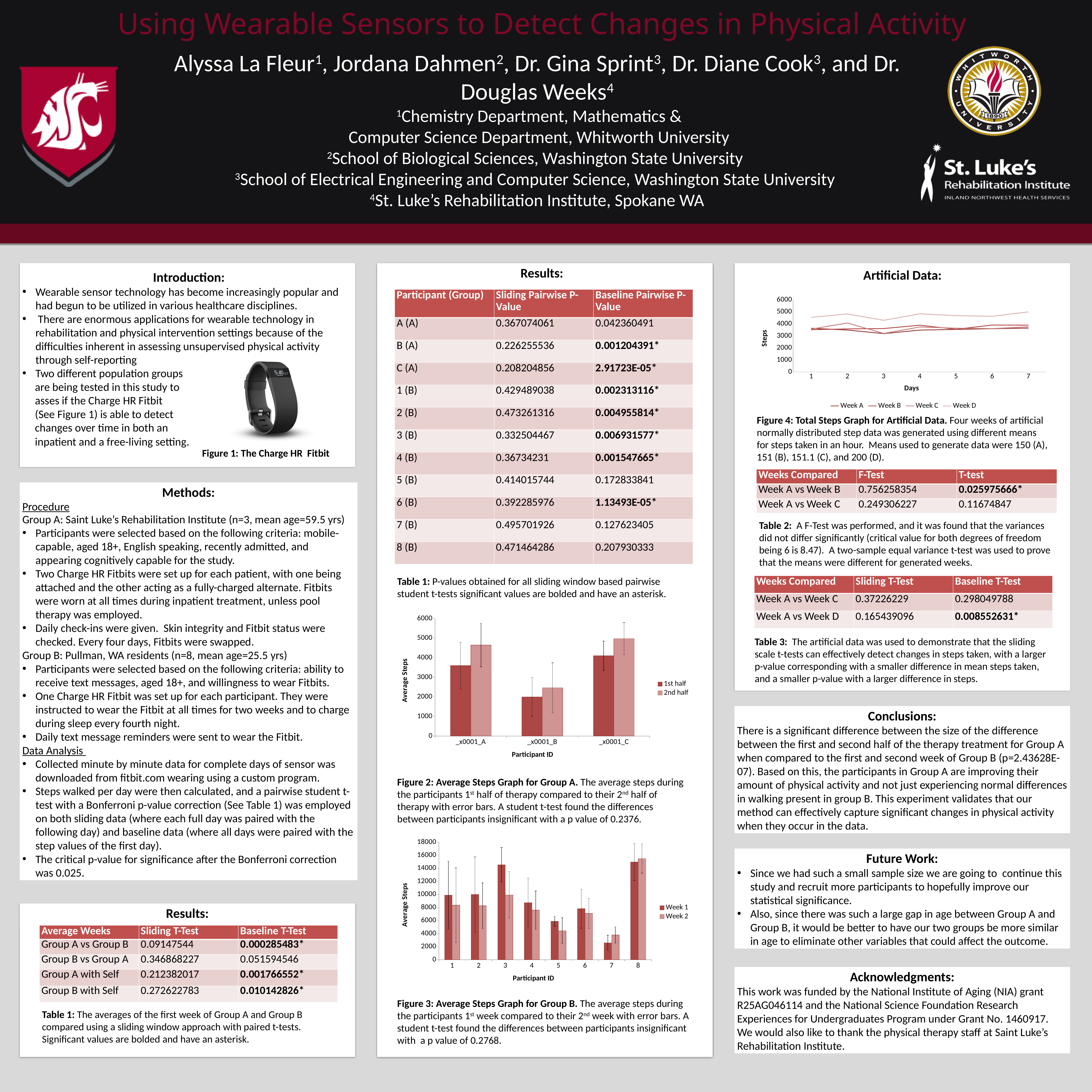
In Figure 2: Average Steps Graph for Group A, is the 2nd half value for _x0001_B greater or less than 3000? less What kind of chart is Figure 4: Total Steps Graph for Artificial Data? line chart In Figure 2: Average Steps Graph for Group A, which participant has the lowest 1st half average steps? _x0001_B In Figure 2: Average Steps Graph for Group A, how many participant categories are shown on the x axis? 3 In Figure 2: Average Steps Graph for Group A, is the 1st half value for _x0001_C greater or less than 3000? greater In Figure 2: Average Steps Graph for Group A, how many series does the legend list? 2 In Figure 3: Average Steps Graph for Group B, is the Week 1 value for participant 3 larger or smaller than the Week 2 value for participant 3? larger In Figure 3: Average Steps Graph for Group B, which participant has the highest Week 1 average steps? 8 In Figure 3: Average Steps Graph for Group B, which participant has the lowest Week 1 average steps? 7 What kind of chart is Figure 2: Average Steps Graph for Group A? bar chart In Figure 3: Average Steps Graph for Group B, how many participants are shown on the x axis? 8 In Figure 4: Total Steps Graph for Artificial Data, how many series does the legend list? 4